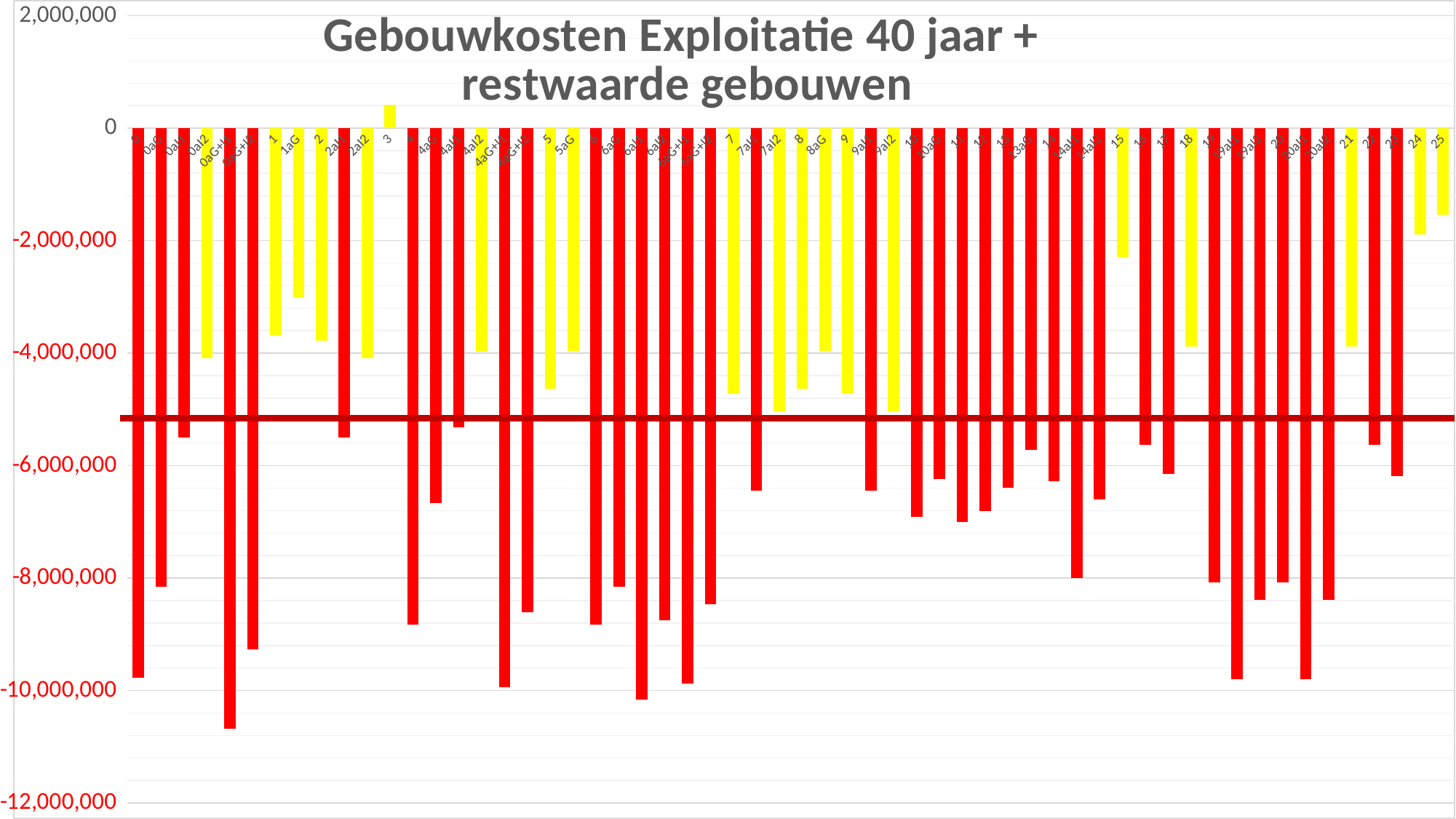
Which category has the lowest value in the chart? 0aG+I1 What is the title of the chart? Gebouwkosten Exploitatie 40 jaar + restwaarde gebouwen Which category has the highest value in the chart? 3 What kind of chart is shown on the slide? bar chart Is the value for 8 greater or less than -4,000,000? less Is the value for 3 greater or less than 0? greater Is the value for 1aG greater or less than -2,000,000? less What two colours are used for the bars in the chart? red and yellow